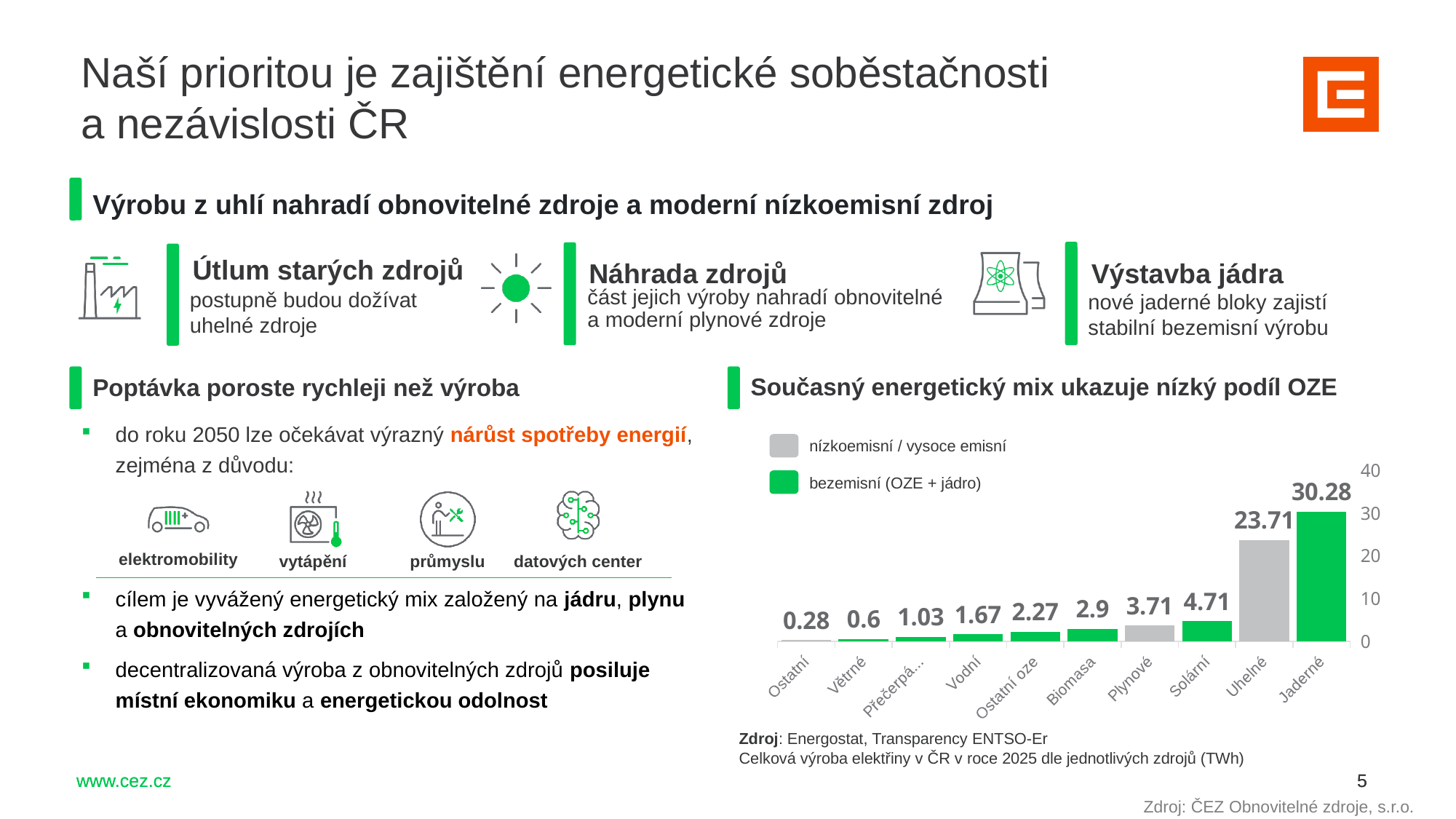
What is the value for Jaderné in the chart? 30.28 What is the value for Větrné in the chart? 0.6 How many entries does the chart legend list? 2 What is the difference between the values for Jaderné and Uhelné? 6.57 Which is larger, the value for Plynové or the value for Biomasa? Plynové Which category has the highest value in the chart? Jaderné Which category has the lowest value in the chart? Ostatní Is the value for Uhelné greater or less than 20? greater What is the value for Solární in the chart? 4.71 What kind of chart is shown on the slide? bar chart How many categories are shown on the x axis of the chart? 10 What is the value for Uhelné in the chart? 23.71